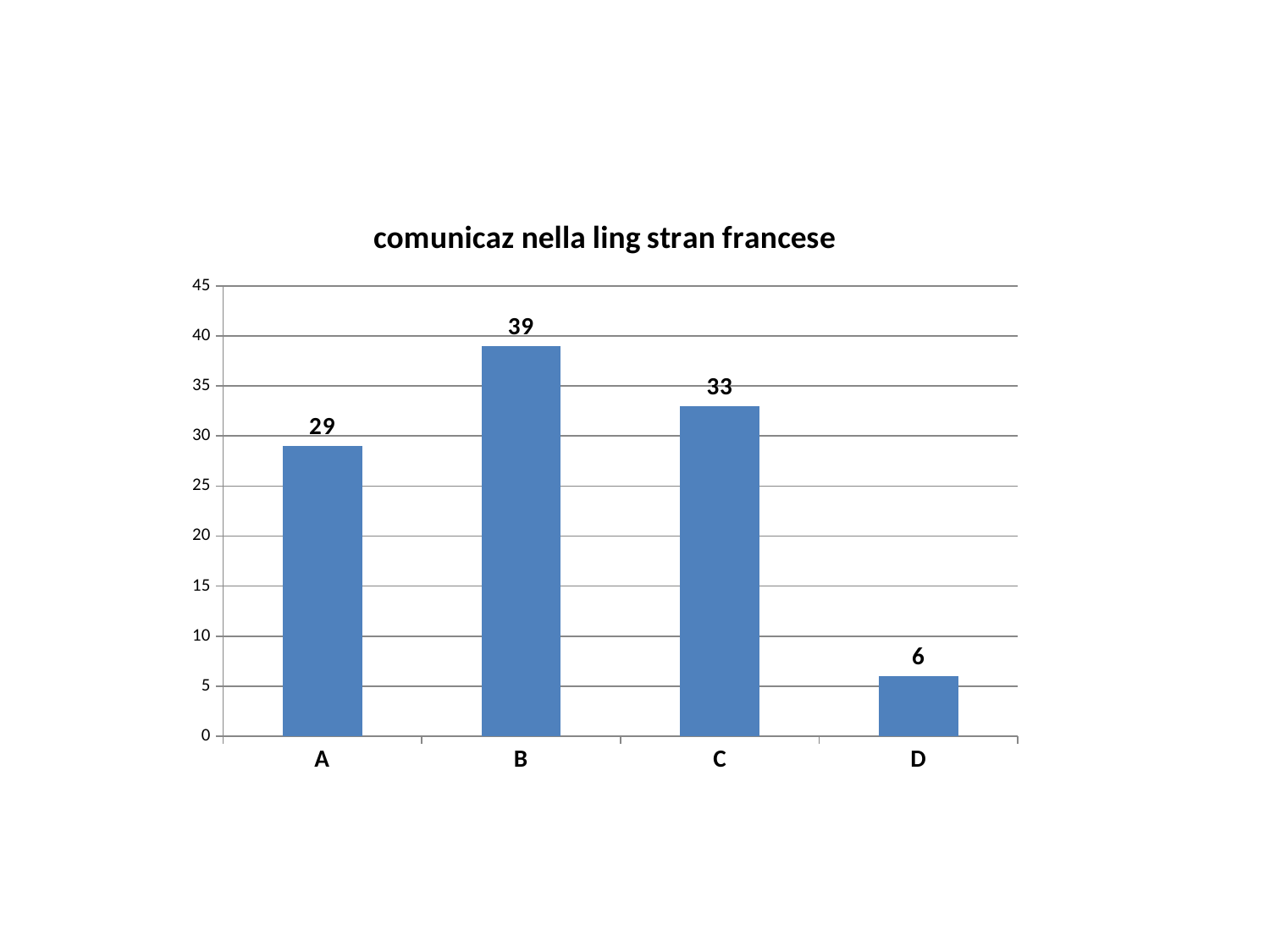
Which category has the highest value? B Is the value for C greater or less than 30? greater What is the difference between the values for A and D? 23 What is the value for category D? 6 Which is larger, the value for A or the value for C? C What is the value for category B? 39 What is the difference between the values for B and C? 6 What is the title of the chart? comunicaz nella ling stran francese What is the value for category A? 29 How many categories are shown on the x axis? 4 Which category has the lowest value? D What kind of chart is shown on the slide? bar chart